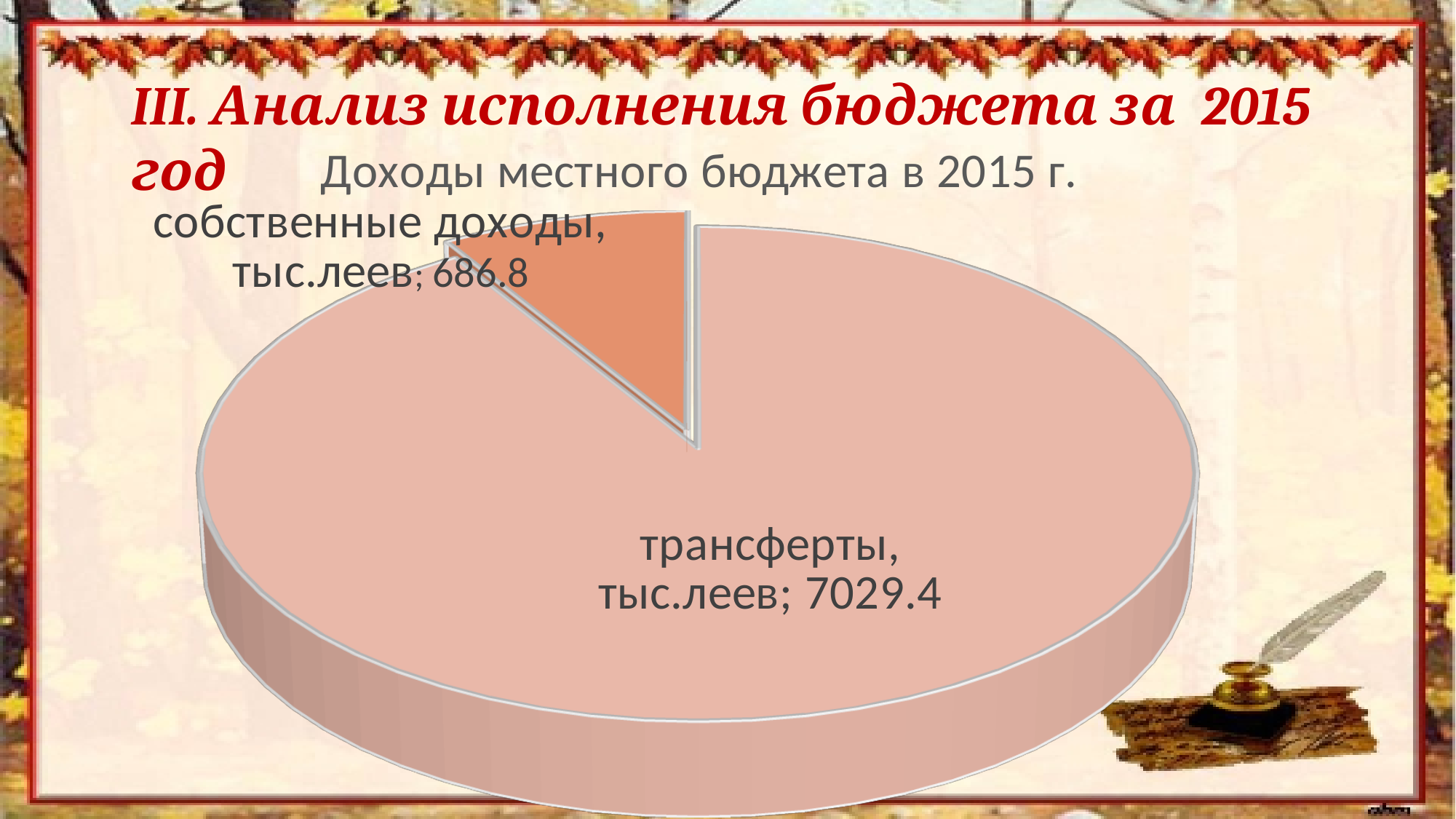
Which slice of the pie is the smallest? собственные доходы, тыс.леев Which slice of the pie is the largest? трансферты, тыс.леев What is the value for собственные доходы, тыс.леев? 686.8 What kind of chart is shown on the slide? pie chart What is the total of the two slices in the pie chart? 7716.2 How many slices does the pie chart have? 2 What is the difference between трансферты and собственные доходы? 6342.6 Which is larger, трансферты or собственные доходы? трансферты What colour is the slice for собственные доходы? orange What is the value for трансферты, тыс.леев? 7029.4 What is the title of the chart? Доходы местного бюджета в 2015 г.